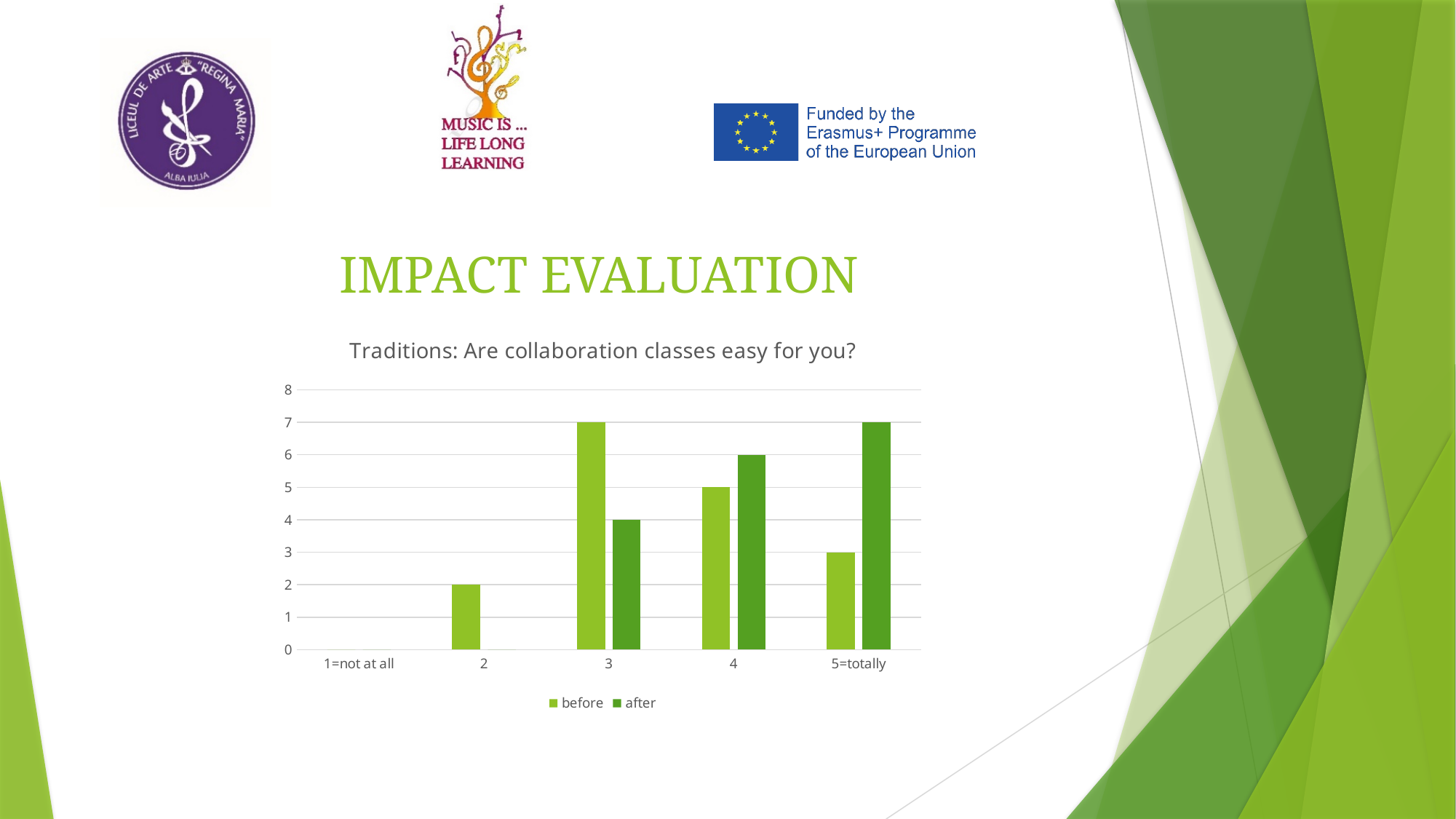
How many categories are shown on the x axis? 5 Which category has the highest 'before' value? 3 For category 3, which is larger, the 'before' value or the 'after' value? before What kind of chart is shown on the slide? bar chart How many series does the legend list? 2 What is the 'before' value for category 3? 7 Is the 'after' value for category 4 greater or less than 5? greater What is the difference between the 'after' and 'before' values for category 4? 1 What is the title of the chart? Traditions: Are collaboration classes easy for you? What is the 'after' value for category 5=totally? 7 Which category has the highest 'after' value? 5=totally What is the 'before' value for category 2? 2